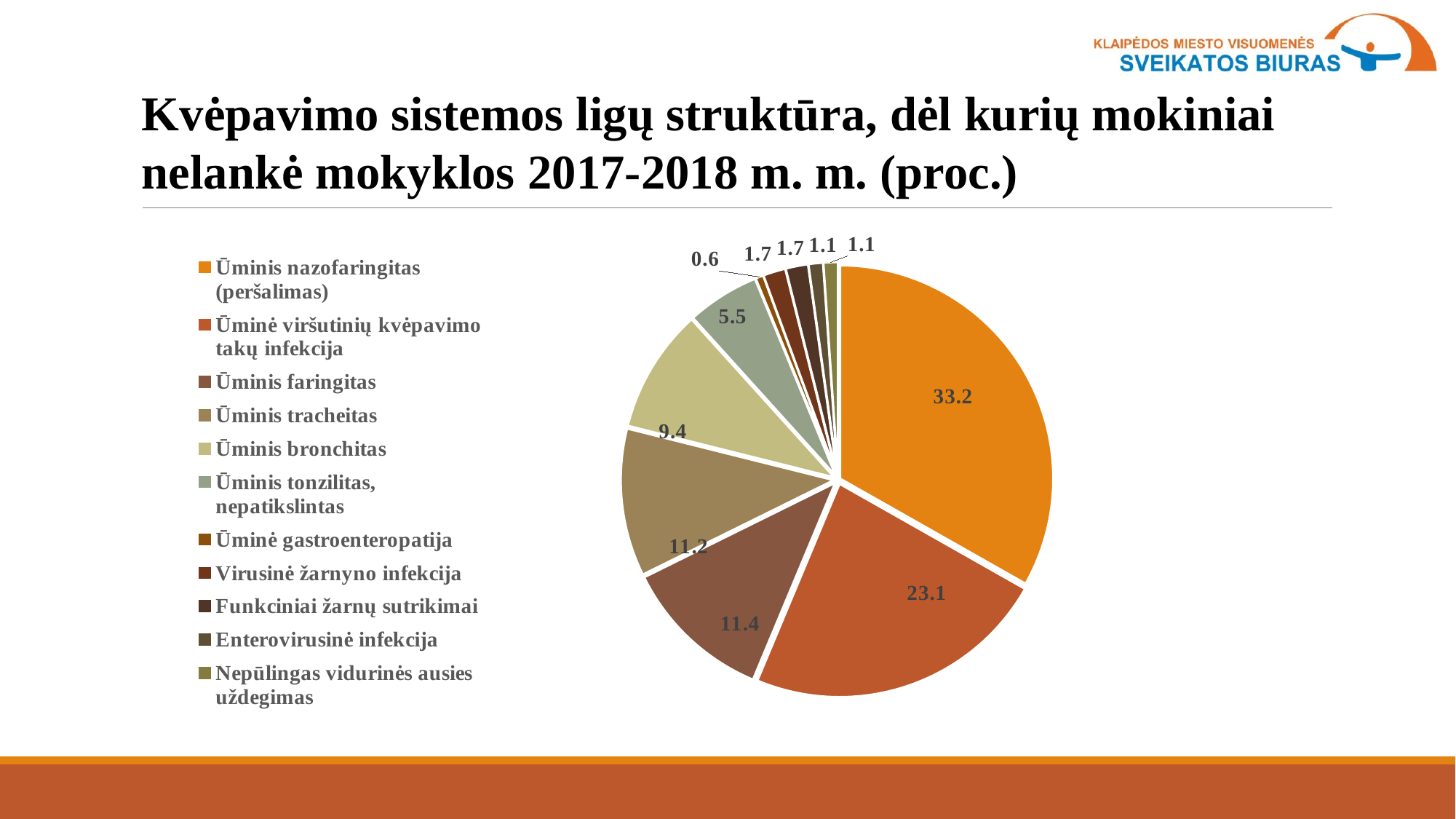
What is the value for Ūminis bronchitas? 9.4 What type of chart is shown on the slide? pie chart What is the value for Ūminė gastroenteropatija? 0.6 Which is larger, the value for Ūminis tracheitas or the value for Ūminis bronchitas? Ūminis tracheitas What is the value for Ūminis nazofaringitas (peršalimas)? 33.2 How many categories does the pie chart have? 11 What is the value for Ūminis tonzilitas, nepatikslintas? 5.5 Which category has the largest slice of the pie? Ūminis nazofaringitas (peršalimas) What is the value for Ūminė viršutinių kvėpavimo takų infekcija? 23.1 What is the difference between the values for Ūminis nazofaringitas (peršalimas) and Ūminė viršutinių kvėpavimo takų infekcija? 10.1 Which category has the smallest slice of the pie? Ūminė gastroenteropatija What share of the pie does Ūminis faringitas represent? 11.4